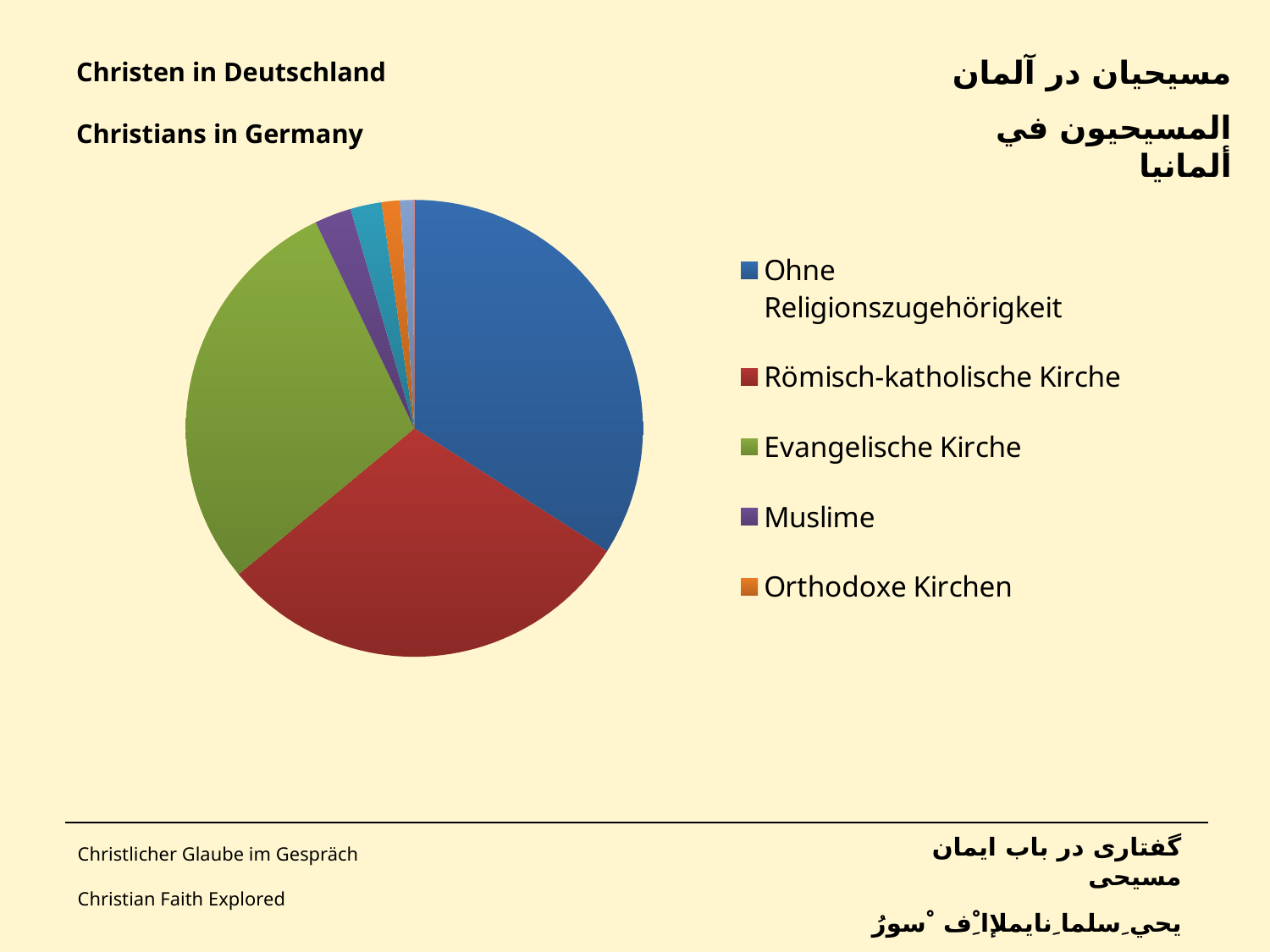
Which category has the largest slice of the pie? Ohne Religionszugehörigkeit How many entries does the chart legend list? 5 Which slice is larger, Evangelische Kirche or Orthodoxe Kirchen? Evangelische Kirche Which slice is larger, Muslime or Orthodoxe Kirchen? Muslime Which slice is larger, Ohne Religionszugehörigkeit or Muslime? Ohne Religionszugehörigkeit What kind of chart is shown on the slide? pie chart Of the categories listed in the legend, which has the smallest slice? Orthodoxe Kirchen What colour represents Evangelische Kirche in the pie chart? green What is the English title given for the chart on the slide? Christians in Germany